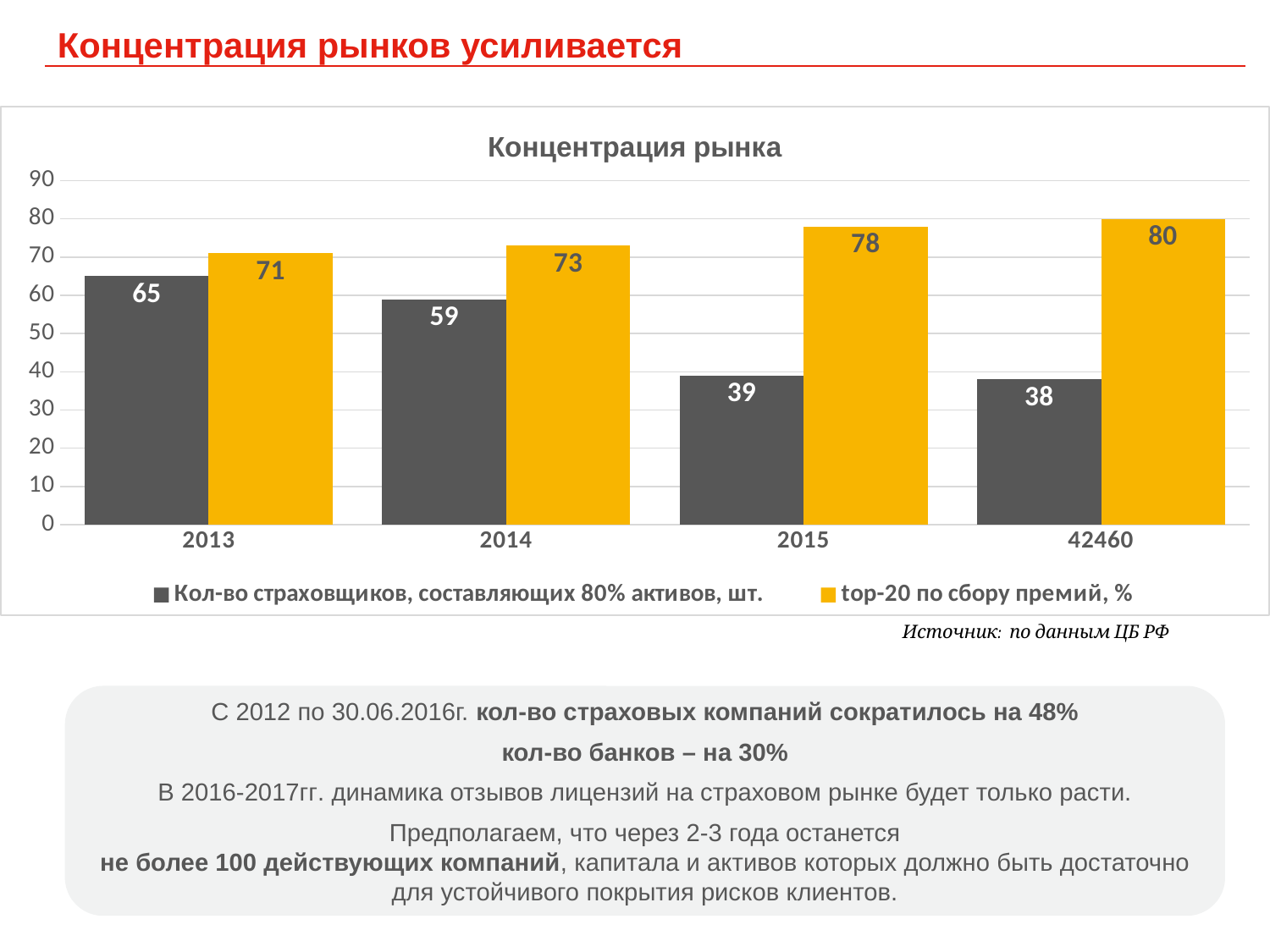
Which is larger for 2013: 'Кол-во страховщиков, составляющих 80% активов, шт.' or 'top-20 по сбору премий, %'? top-20 по сбору премий, % What is the value of 'Кол-во страховщиков, составляющих 80% активов, шт.' for 2013? 65 What is the value of 'top-20 по сбору премий, %' for 2015? 78 How many series does the legend list? 2 What is the value of 'top-20 по сбору премий, %' for 2014? 73 What is the difference between the 'top-20 по сбору премий, %' value and the 'Кол-во страховщиков' value for 2015? 39 Does the 'Кол-во страховщиков, составляющих 80% активов, шт.' series rise or fall along the x axis? fall Which category has the lowest value for 'Кол-во страховщиков, составляющих 80% активов, шт.'? 42460 How many categories are shown on the x axis? 4 What kind of chart is shown? bar chart What is the value of 'Кол-во страховщиков, составляющих 80% активов, шт.' for the category labelled 42460? 38 Which category has the highest value for 'top-20 по сбору премий, %'? 42460